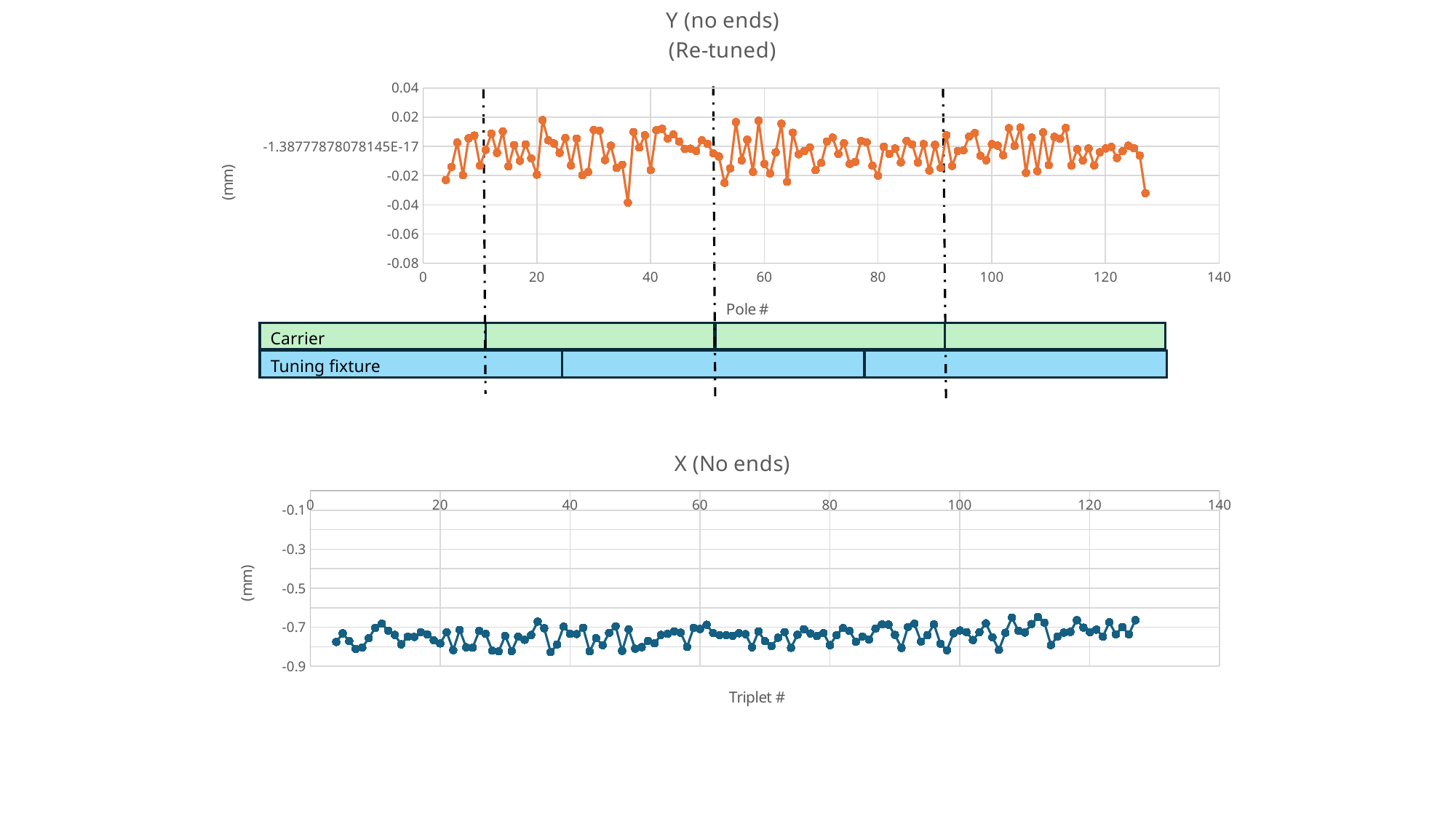
What kind of chart is the bottom chart titled "X (No ends)"? line chart In the top chart "Y (no ends) (Re-tuned)", do the values show a strong rise, a strong fall, or stay roughly flat along the x axis? roughly flat In the bottom chart "X (No ends)", are the plotted values greater or less than -0.9? greater In the bottom chart "X (No ends)", are the plotted values greater or less than -0.5? less In the bottom chart "X (No ends)", do the values show a strong rise, a strong fall, or stay roughly flat along the x axis? roughly flat What kind of chart is the top chart titled "Y (no ends) (Re-tuned)"? line chart In the top chart "Y (no ends) (Re-tuned)", is the lowest plotted point greater or less than -0.06? greater In the bottom chart "X (No ends)", what is the label of the x axis? Triplet # In the top chart "Y (no ends) (Re-tuned)", what is the label of the x axis? Pole #